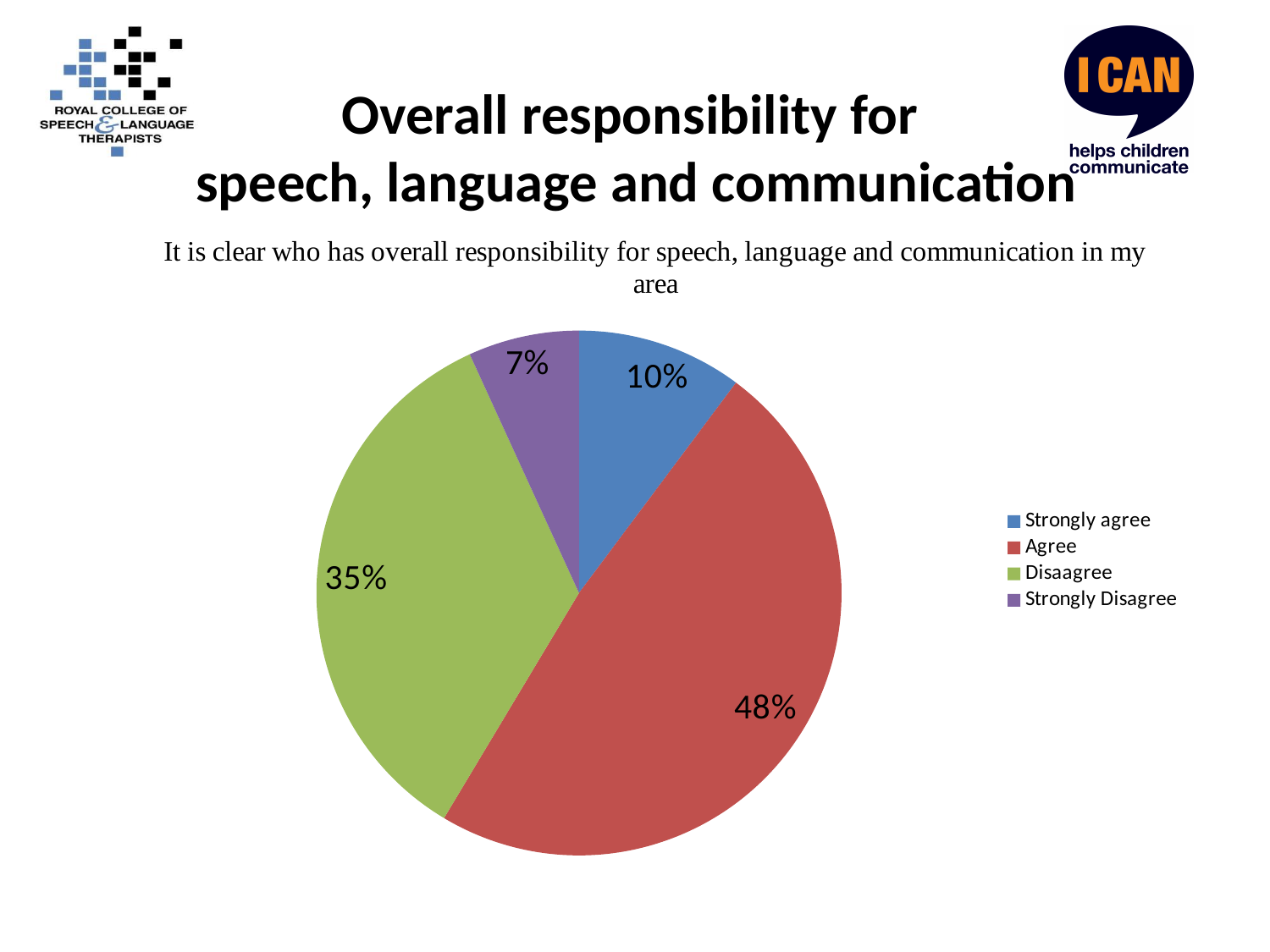
Which response category has the largest share of the pie? Agree What percentage of respondents chose 'Disaagree'? 35% Which response category has the smallest share of the pie? Strongly Disagree What is the combined percentage for 'Strongly agree' and 'Agree'? 58% What percentage of respondents chose 'Strongly Disagree'? 7% Which is larger, the share for 'Strongly agree' or the share for 'Strongly Disagree'? Strongly agree How many categories does the legend list? 4 What percentage of respondents chose 'Agree'? 48% What is the difference in percentage points between 'Agree' and 'Disaagree'? 13 What kind of chart is shown on the slide? pie chart What colour is the slice for 'Disaagree'? green What percentage of respondents chose 'Strongly agree'? 10%